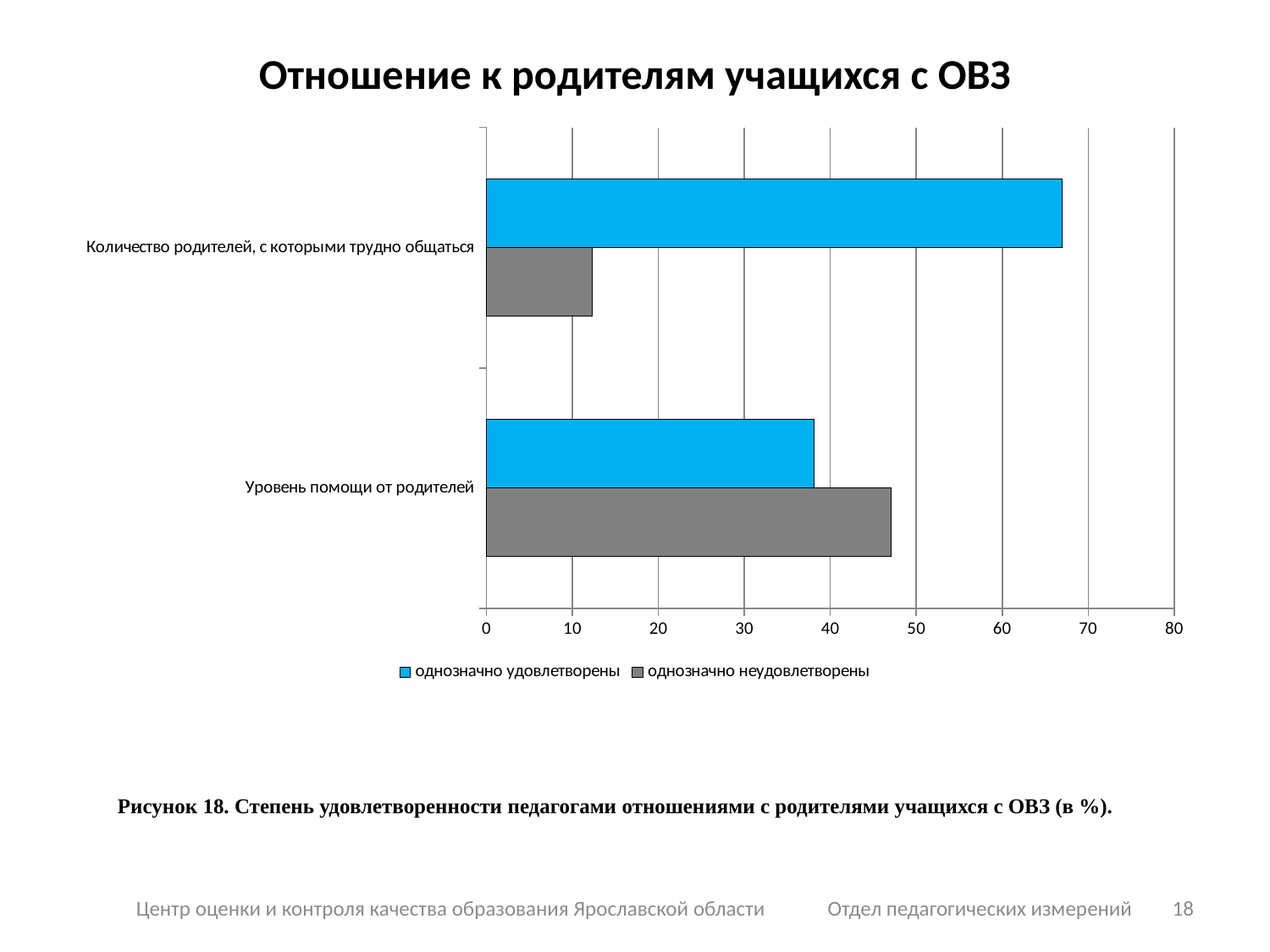
Which category has the lowest value for the series 'однозначно неудовлетворены'? Количество родителей, с которыми трудно общаться For the category 'Уровень помощи от родителей', which series has the larger value: 'однозначно удовлетворены' or 'однозначно неудовлетворены'? однозначно неудовлетворены Is the value for 'однозначно удовлетворены' in the category 'Уровень помощи от родителей' greater or less than 30? greater How many categories are shown on the chart? 2 Which category has the highest value for the series 'однозначно удовлетворены'? Количество родителей, с которыми трудно общаться Is the value for 'однозначно удовлетворены' in the category 'Количество родителей, с которыми трудно общаться' greater or less than 60? greater What kind of chart is shown on the slide? bar chart Is the value for 'однозначно неудовлетворены' in the category 'Уровень помощи от родителей' greater or less than 50? less For the category 'Количество родителей, с которыми трудно общаться', which series has the larger value: 'однозначно удовлетворены' or 'однозначно неудовлетворены'? однозначно удовлетворены How many series does the legend list? 2 What is the title of the chart on the slide? Отношение к родителям учащихся с ОВЗ